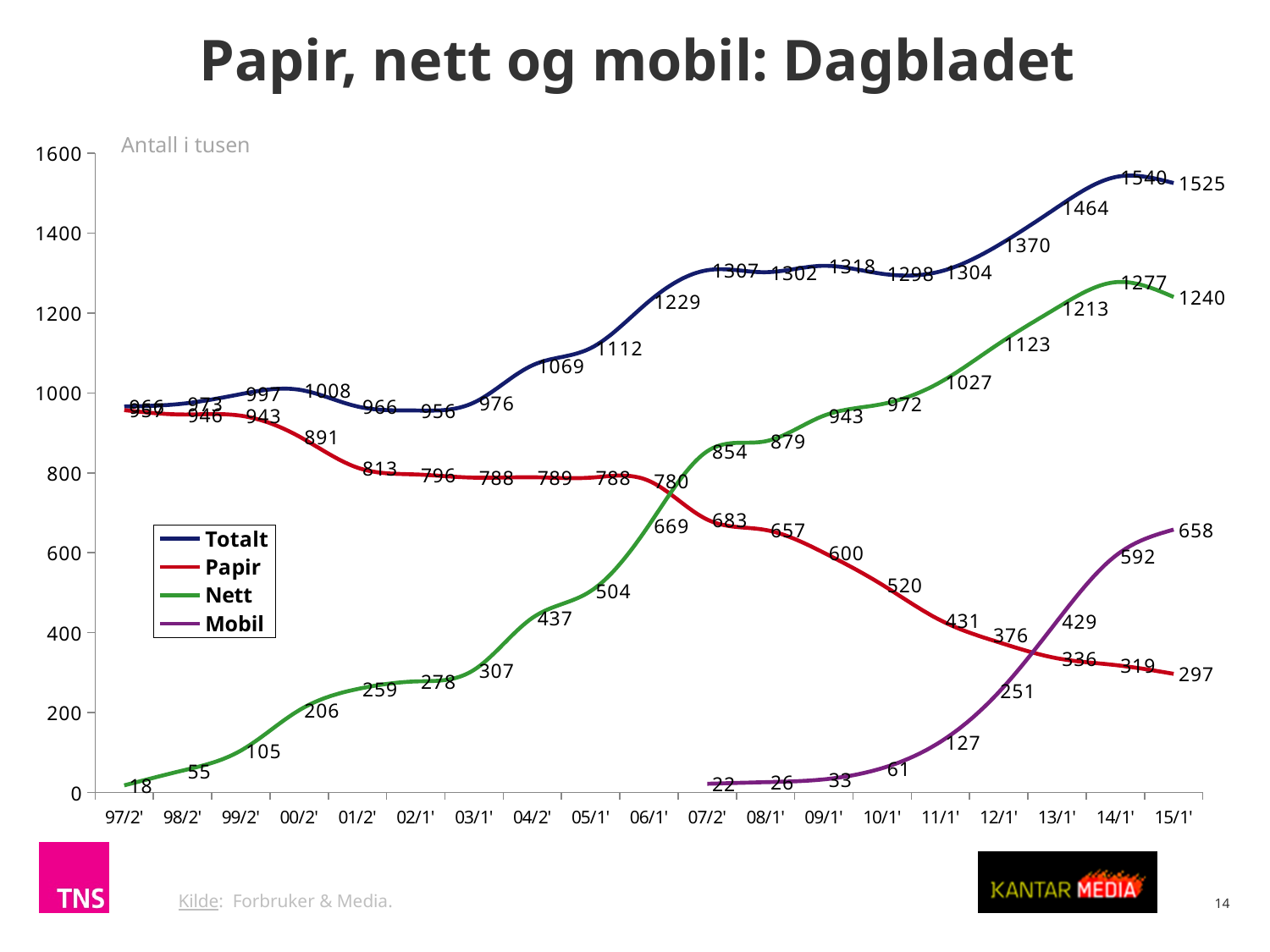
At which period is the Papir series at its lowest value? 15/1' How many data points does the Mobil series have? 9 At 15/1', which is larger: Mobil or Papir? Mobil What is the value of Mobil at 13/1'? 429 What is the value of Nett at 15/1'? 1240 What is the value of Papir at 11/1'? 431 What kind of chart is shown on the slide? line chart What is the difference between Nett and Papir at 15/1'? 943 What is the value of Totalt at 15/1'? 1525 At which period does the Totalt series reach its highest value? 14/1' How many series does the legend list? 4 Does the Papir series rise or fall from 97/2' to 15/1'? fall